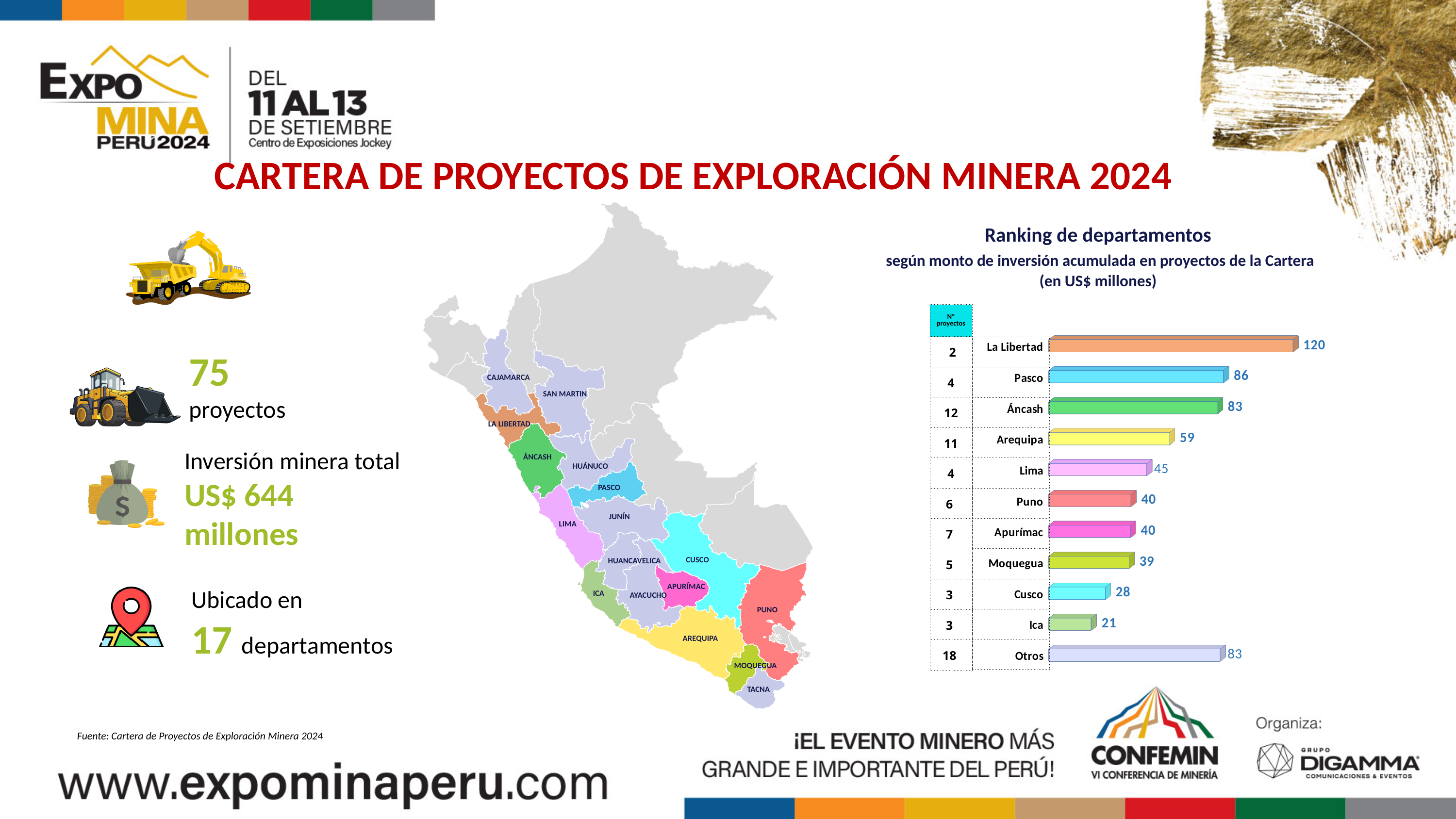
In the 'Ranking de departamentos' chart, which department has the lowest investment value? Ica What unit is stated in the subtitle of the 'Ranking de departamentos' chart? US$ millones What kind of chart is used in 'Ranking de departamentos'? bar chart In the 'Ranking de departamentos' chart, how many projects (N° proyectos) are listed for Áncash? 12 In the 'Ranking de departamentos' chart, what is the value for Moquegua? 39 In the 'Ranking de departamentos' chart, what is the value for La Libertad? 120 In the 'Ranking de departamentos' chart, what is the difference between the values for La Libertad and Pasco? 34 In the 'Ranking de departamentos' chart, which department has the highest investment value? La Libertad In the 'Ranking de departamentos' chart, what is the value for Arequipa? 59 In the 'Ranking de departamentos' chart, what is the value for Otros? 83 How many bars are shown in the 'Ranking de departamentos' chart? 11 In the 'Ranking de departamentos' chart, which is larger, the value for Arequipa or the value for Lima? Arequipa